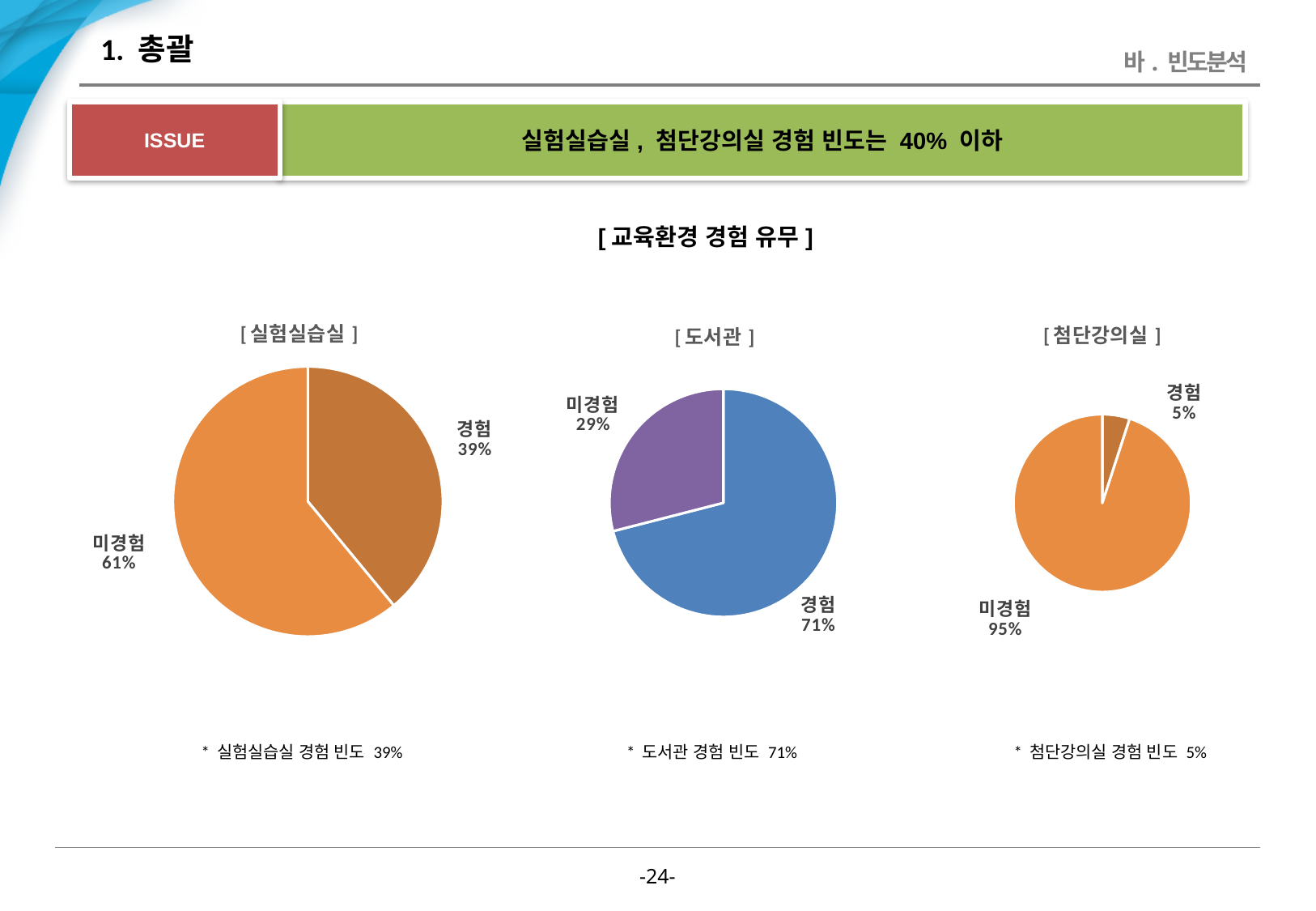
In the [실험실습실] pie chart, what is the value for 경험? 39% In the [첨단강의실] pie chart, what is the value for 경험? 5% In the [실험실습실] pie chart, what is the value for 미경험? 61% In the [첨단강의실] pie chart, which slice is the smallest? 경험 In the [도서관] pie chart, what is the value for 경험? 71% Which is larger: 경험 in the [실험실습실] chart or 경험 in the [도서관] chart? 경험 in the [도서관] chart In the [첨단강의실] pie chart, what is the value for 미경험? 95% In the [도서관] pie chart, what is the value for 미경험? 29% How many slices does the [도서관] pie chart have? 2 In the [도서관] pie chart, which slice is the largest? 경험 In the [실험실습실] pie chart, what is the difference between 미경험 and 경험? 22% What kind of chart is the [첨단강의실] chart? Pie chart